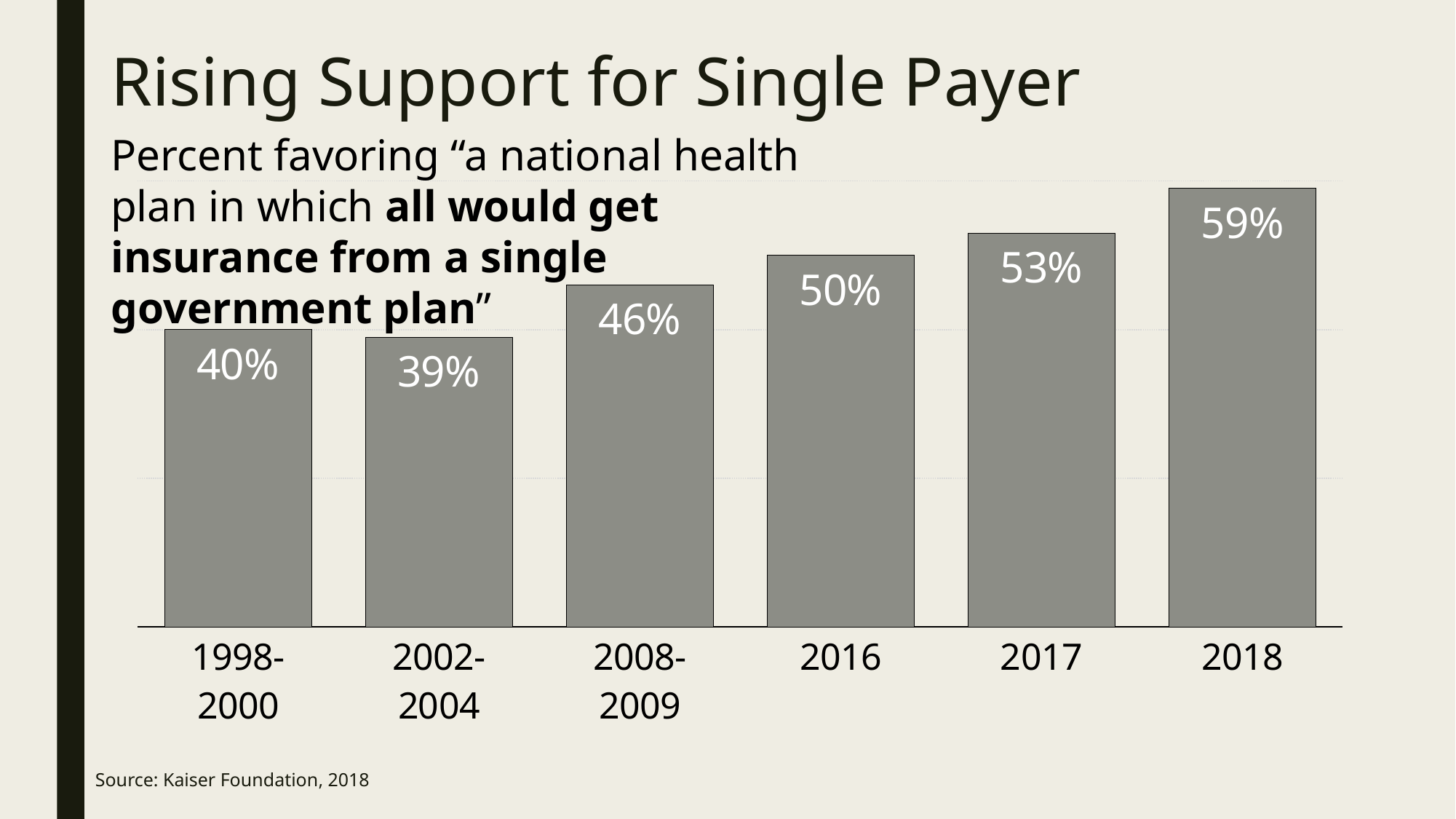
What percent favored a single government health plan in 2018? 59% What is the difference between the values for 2017 and 2016? 3% Which period has the highest value? 2018 What is the value shown for 2017? 53% What kind of chart is shown on the slide? Bar chart Which is larger, the value for 2008-2009 or the value for 2016? 2016 Which period has the lowest value? 2002-2004 Do the values generally rise or fall from 2008-2009 to 2018? Rise How many periods are shown on the x axis? 6 What is the difference between the values for 2018 and 1998-2000? 19% What is the value shown for 2008-2009? 46% What is the value shown for 1998-2000? 40%